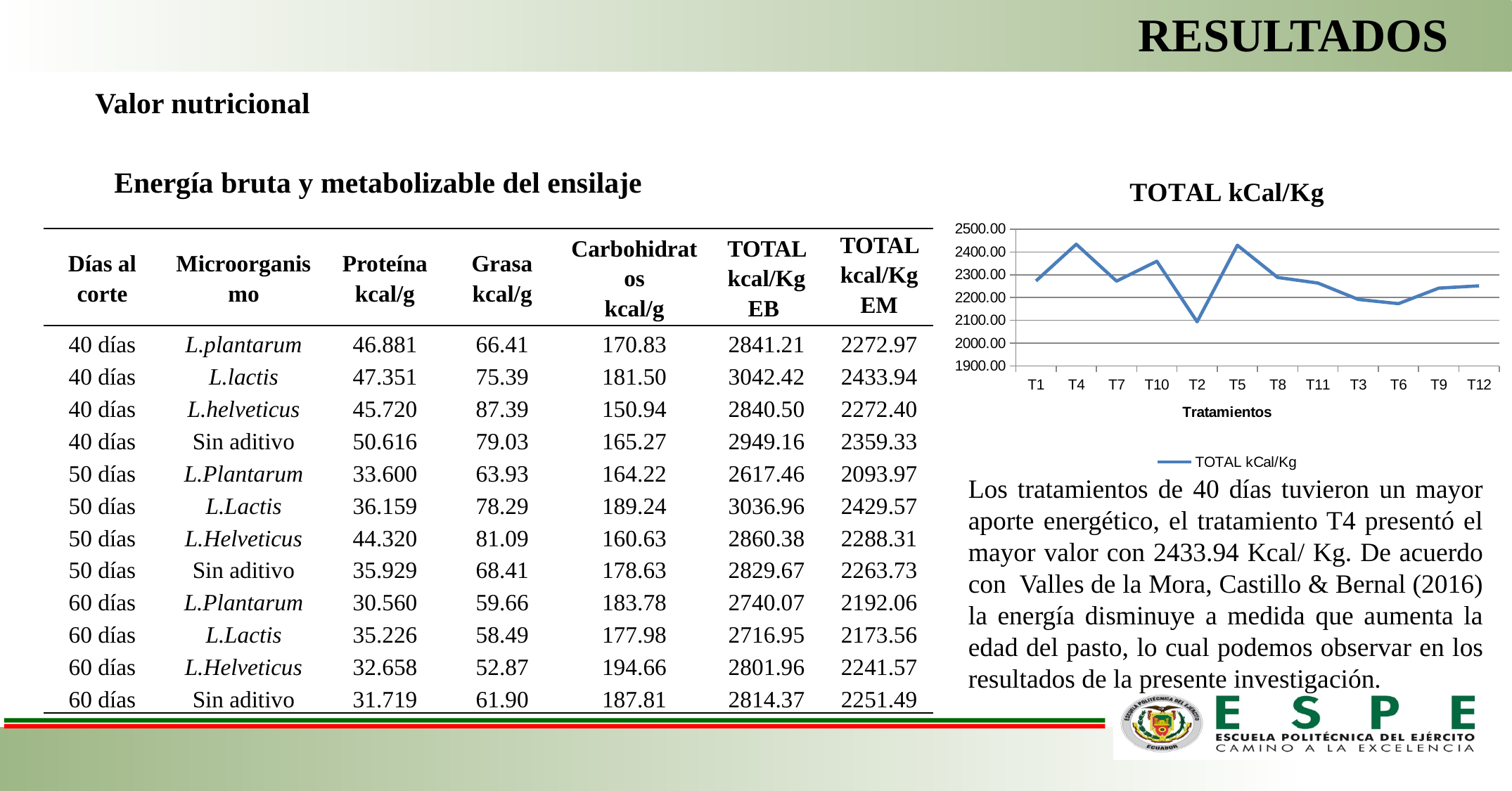
In the "TOTAL kCal/Kg" chart, which has the larger value, T10 or T7? T10 What is the x-axis title of the "TOTAL kCal/Kg" chart? Tratamientos Is the value for T4 in the "TOTAL kCal/Kg" chart greater or less than 2400? greater How many treatments are plotted along the x axis of the "TOTAL kCal/Kg" chart? 12 How many series does the legend of the "TOTAL kCal/Kg" chart list? 1 Is the value for T6 in the "TOTAL kCal/Kg" chart greater or less than 2200? less Is the value for T2 in the "TOTAL kCal/Kg" chart greater or less than 2200? less What type of chart is shown under the title "TOTAL kCal/Kg"? line chart In the "TOTAL kCal/Kg" chart, does the line rise or fall from T5 to T8? fall In the "TOTAL kCal/Kg" chart, which has the larger value, T1 or T6? T1 Which treatment has the lowest value in the "TOTAL kCal/Kg" chart? T2